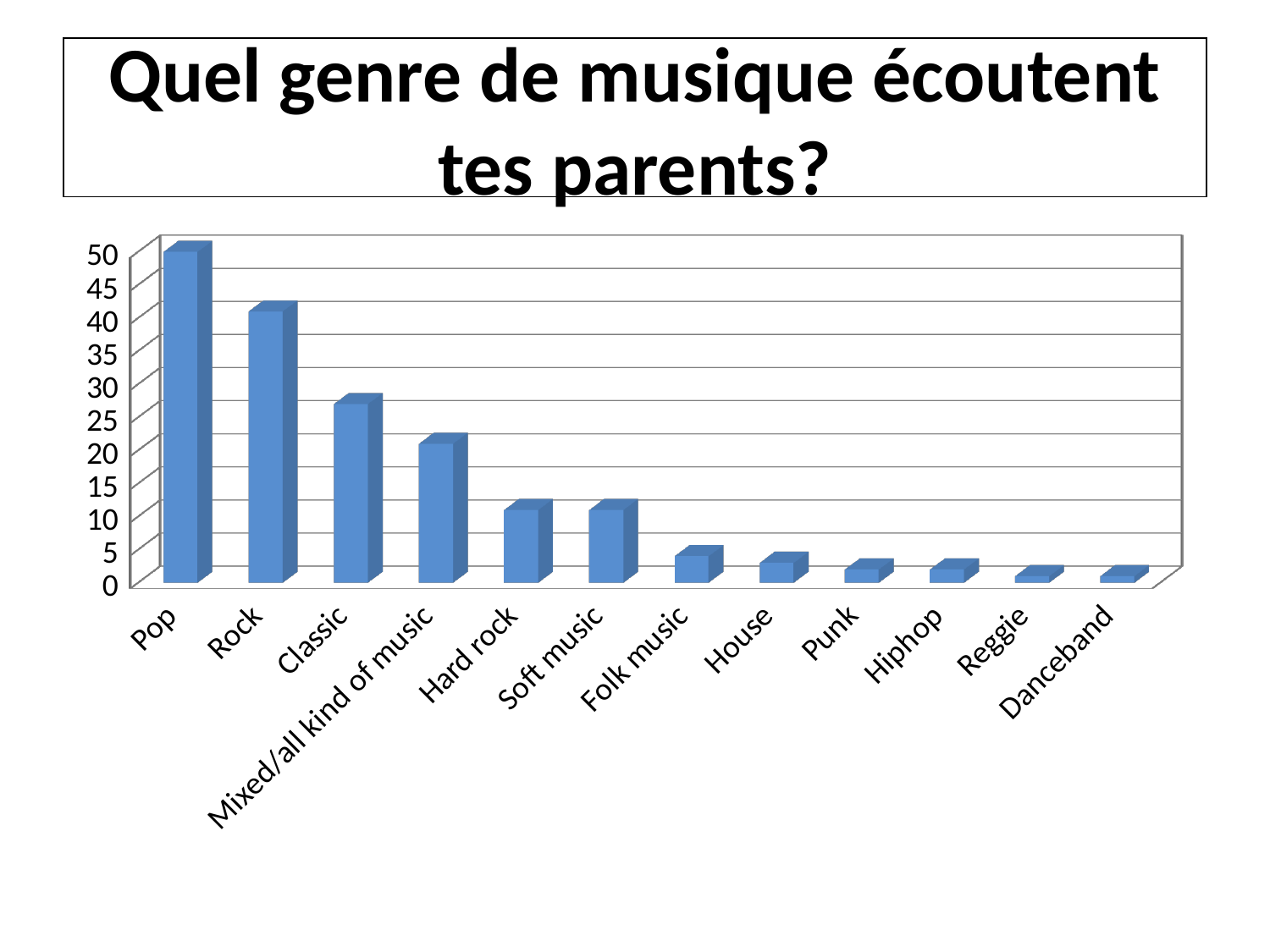
What is the title of the chart? Quel genre de musique écoutent tes parents? Is the value for Rock greater or less than 35? greater Is the value for Pop greater or less than 45? greater Which is larger, the value for Hard rock or the value for Mixed/all kind of music? Mixed/all kind of music Is the value for Classic greater or less than 30? less How many music genres are shown on the x axis? 12 Which is larger, the value for Rock or the value for Classic? Rock Do the values rise or fall moving from left to right along the x axis? fall Which genre has the highest value? Pop What kind of chart is shown on the slide? bar chart